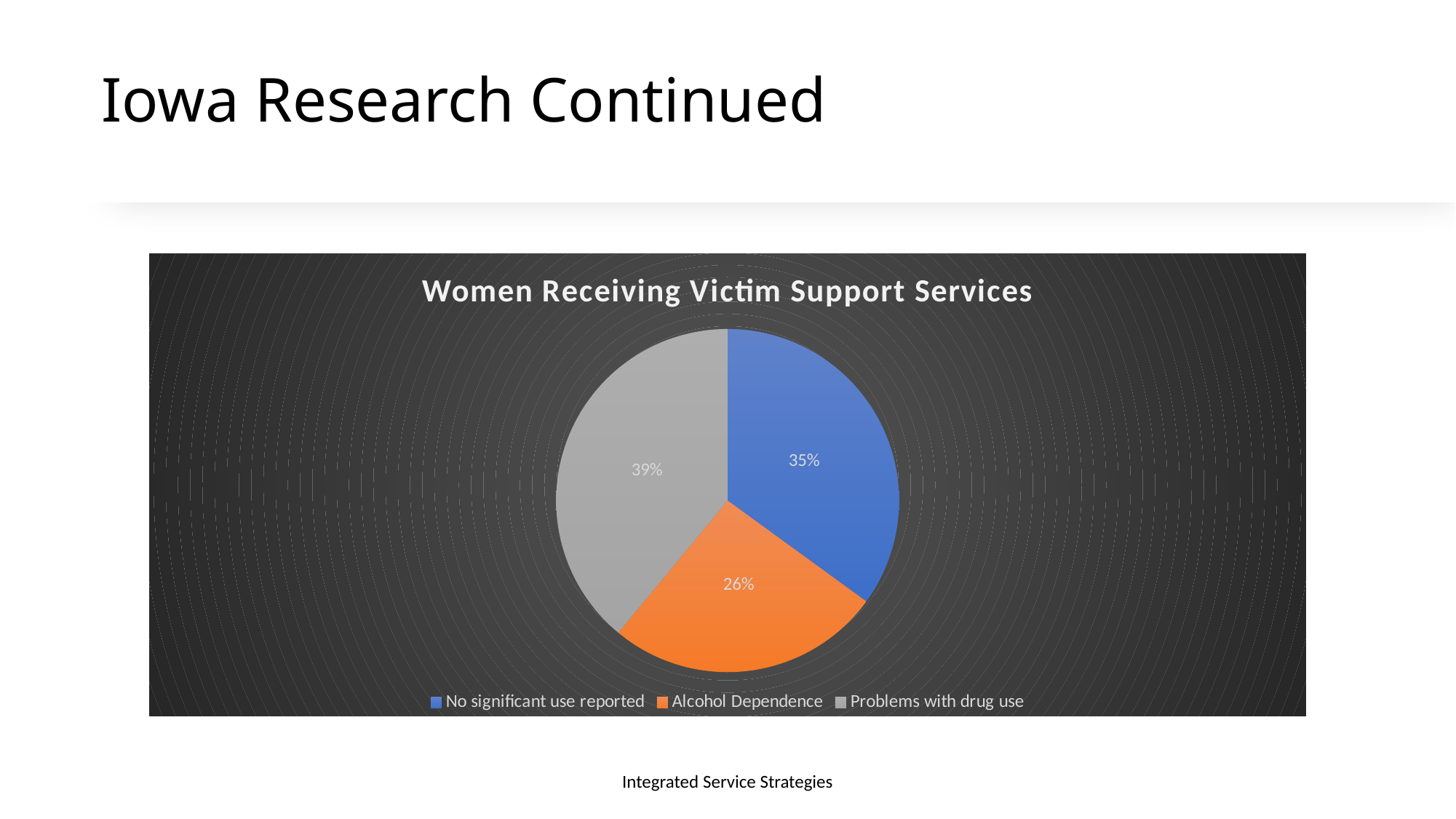
What percentage of the pie is labelled for "No significant use reported"? 35% What kind of chart is shown on the slide? Pie chart Which category has the largest slice of the pie? Problems with drug use What is the difference in percentage points between "Problems with drug use" and "No significant use reported"? 4 What is the difference in percentage points between "Problems with drug use" and "Alcohol Dependence"? 13 What percentage of the pie is labelled for "Problems with drug use"? 39% What percentage of the pie is labelled for "Alcohol Dependence"? 26% Which colour represents "Alcohol Dependence" in the chart? Orange How many slices does the pie chart have? 3 Which category has the smallest slice of the pie? Alcohol Dependence Which is larger: the slice for "No significant use reported" or the slice for "Alcohol Dependence"? No significant use reported What is the title of the chart? Women Receiving Victim Support Services